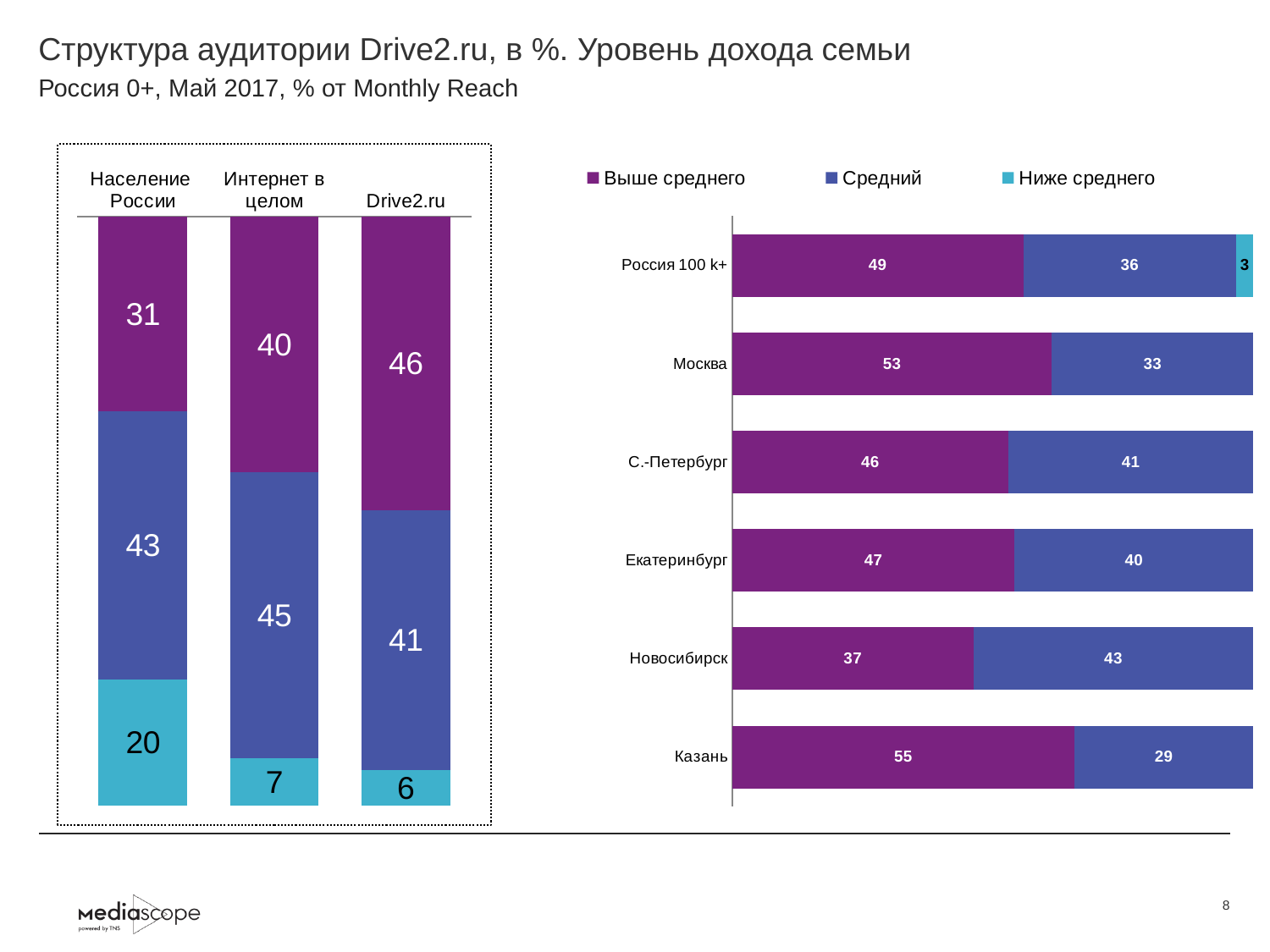
How many series does the legend of the right chart list? 3 In the right chart, which city has the highest 'Выше среднего' value? Казань What type of chart is the right chart? Stacked bar chart In the left chart, what is the total of the stacked bar for Интернет в целом? 92 In the right chart, what is the 'Средний' value for Новосибирск? 43 In the left chart, which is larger: the 'Средний' value for Интернет в целом or for Drive2.ru? Интернет в целом In the left chart, what is the 'Ниже среднего' value for Население России? 20 In the right chart, what is the difference between the 'Выше среднего' values for Москва and Новосибирск? 16 How many cities/regions are shown in the right chart? 6 In the right chart, which city has the lowest 'Средний' value? Казань In the left chart, what is the 'Выше среднего' value for Drive2.ru? 46 In the right chart, what is the 'Ниже среднего' value for Россия 100 k+? 3